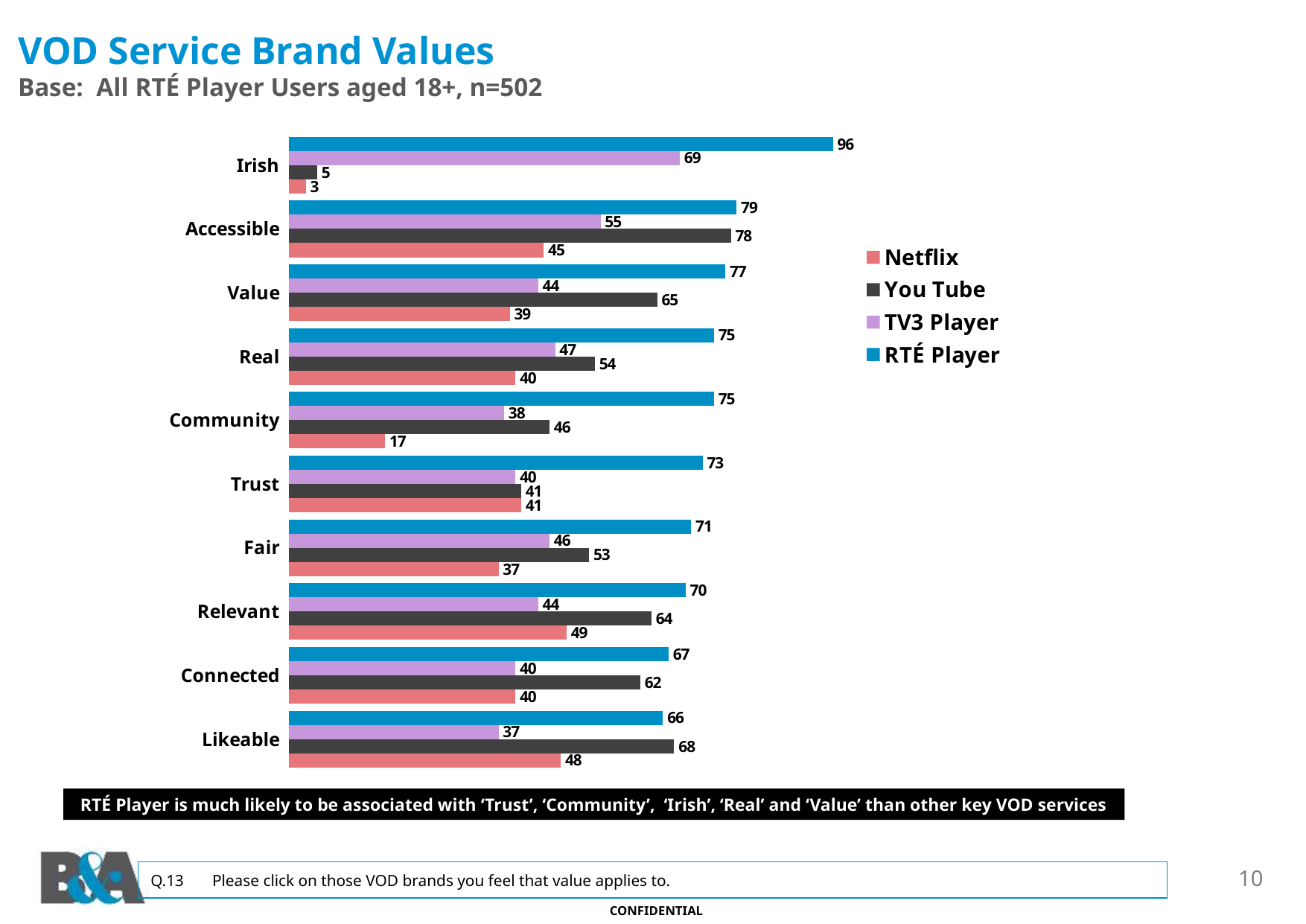
What is the value for TV3 Player on 'Accessible'? 55 What is the value for Netflix on 'Community'? 17 How many categories are shown on the chart? 10 What is the difference between the RTÉ Player and TV3 Player values for 'Irish'? 27 Which category has the lowest value for Netflix? Irish What is the value for You Tube on 'Likeable'? 68 Which category has the highest value for RTÉ Player? Irish How many series does the legend list? 4 What is the value for RTÉ Player on 'Irish'? 96 Which is larger for 'Likeable': the RTÉ Player value or the You Tube value? You Tube Which series is shown in pink/red on the chart? Netflix What kind of chart is shown on the slide? Bar chart